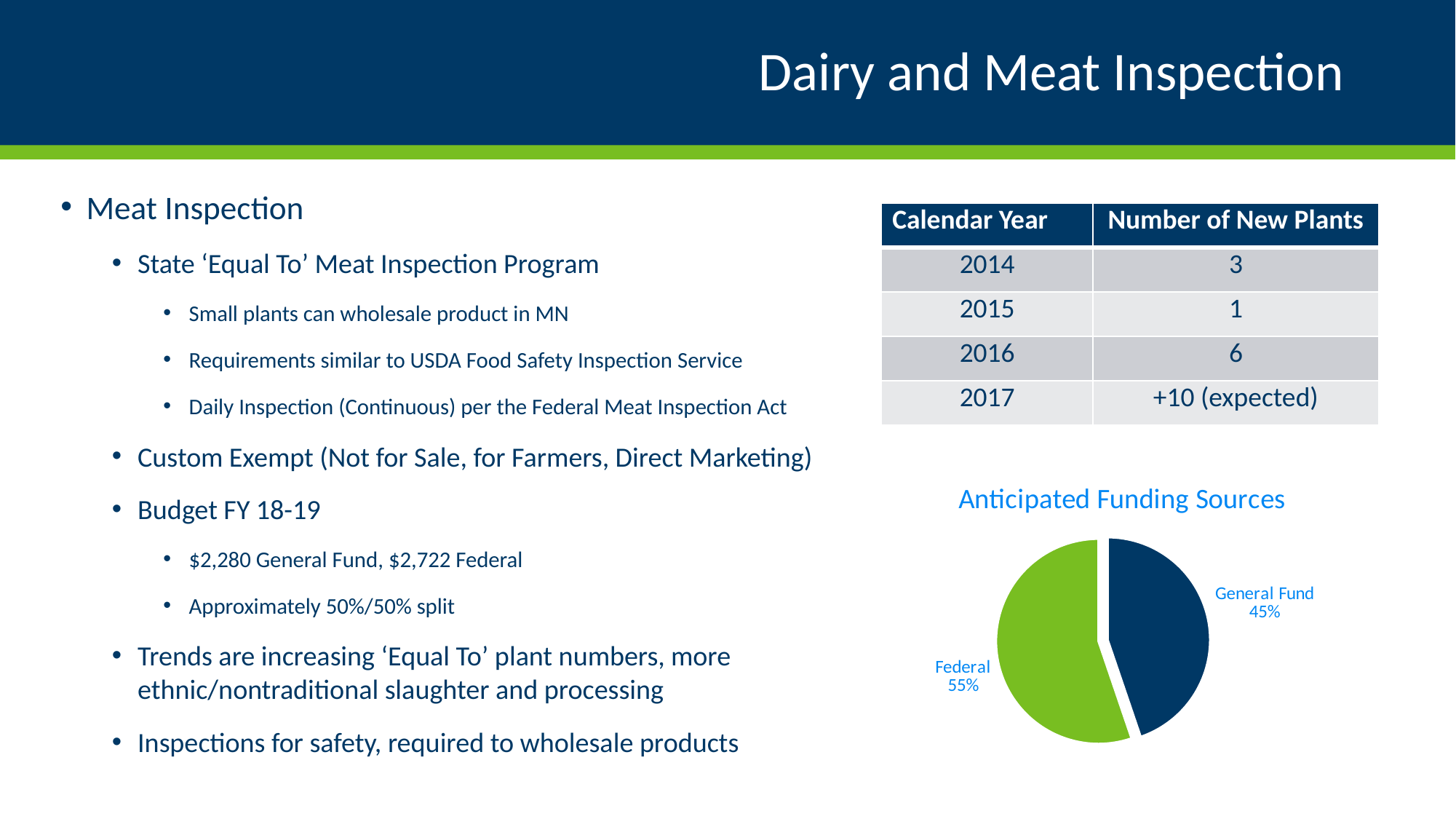
In the "Anticipated Funding Sources" pie chart, how many slices are there? 2 In the "Anticipated Funding Sources" pie chart, which slice is the largest? Federal What kind of chart is "Anticipated Funding Sources"? pie chart What is the title of the pie chart on the slide? Anticipated Funding Sources In the "Anticipated Funding Sources" pie chart, what colour is the Federal slice? green In the "Anticipated Funding Sources" pie chart, what is the difference in percentage points between the Federal and General Fund shares? 10 In the "Anticipated Funding Sources" pie chart, which is larger, Federal or General Fund? Federal In the "Anticipated Funding Sources" pie chart, which slice is the smallest? General Fund In the "Anticipated Funding Sources" pie chart, what share is Federal? 55% In the "Anticipated Funding Sources" pie chart, what share is General Fund? 45%